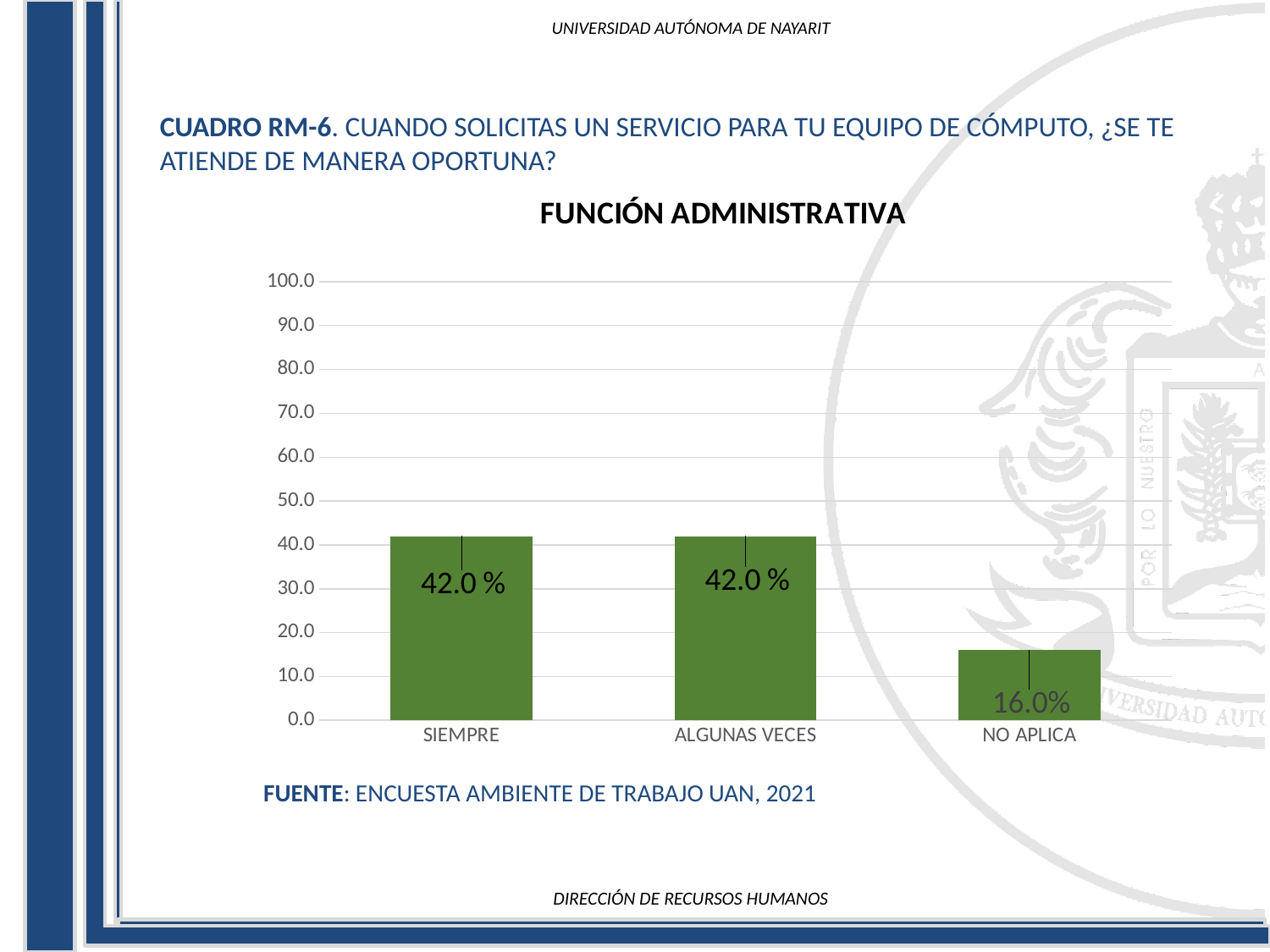
Which is larger, the value for ALGUNAS VECES or the value for NO APLICA? ALGUNAS VECES What is the value for NO APLICA? 16.0% What is the value for SIEMPRE? 42.0 % What kind of chart is shown? bar chart Is the value for SIEMPRE greater or less than 40.0? greater What is the maximum value shown on the y axis? 100.0 What is the difference between the values for SIEMPRE and NO APLICA? 26.0 What is the value for ALGUNAS VECES? 42.0 % Is the value for NO APLICA greater or less than 20.0? less What is the title of the chart? FUNCIÓN ADMINISTRATIVA Which category has the lowest value? NO APLICA How many categories are shown on the x axis? 3